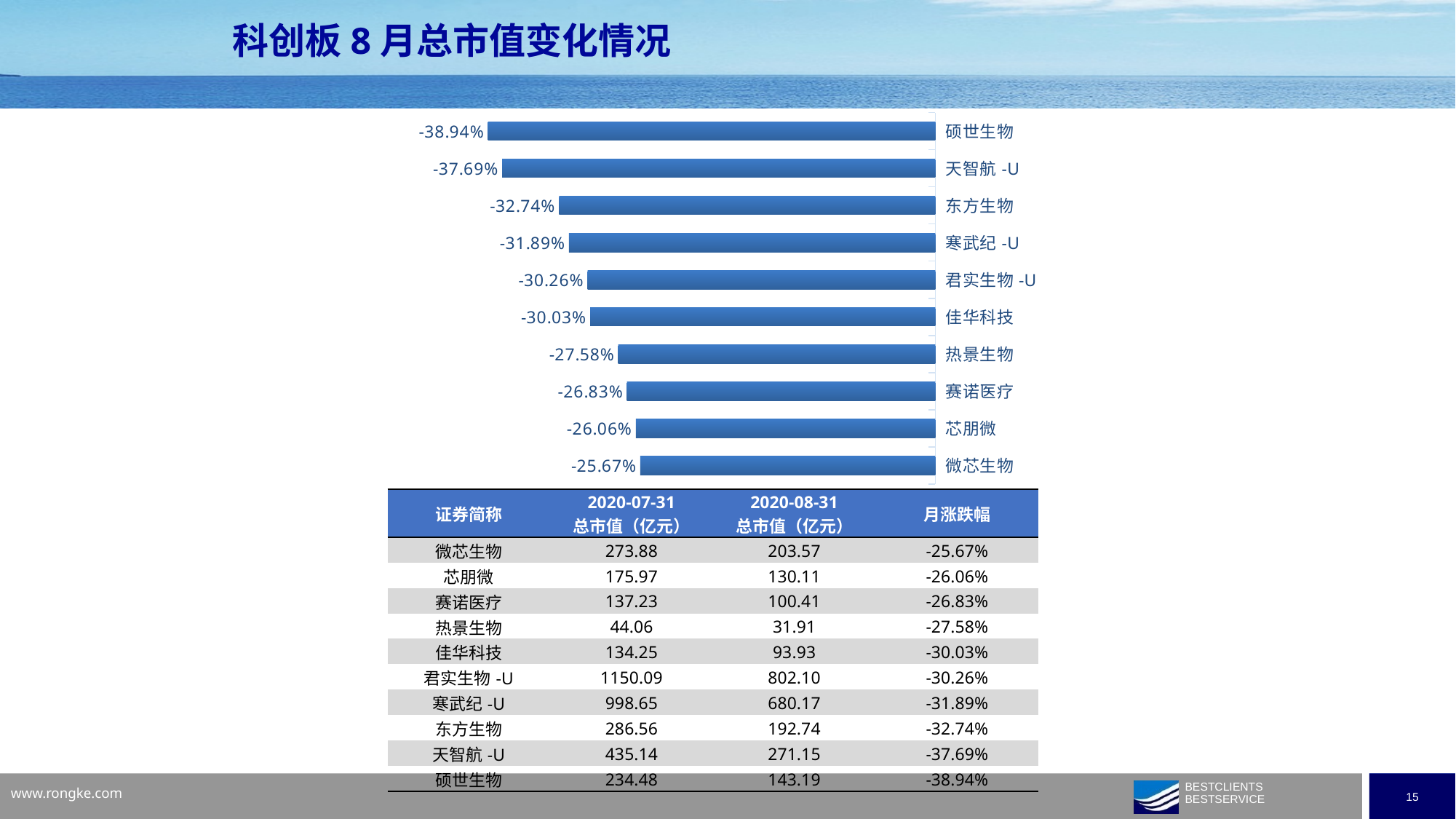
What is the value shown for 寒武纪 -U in the bar chart? -31.89% What is the value shown for 硕世生物 in the bar chart? -38.94% What is the title of the slide containing the chart? 科创板 8 月总市值变化情况 What is the difference in percentage points between the values for 天智航 -U and 东方生物 in the bar chart? 4.95 percentage points Which category in the bar chart has the largest decline (the most negative value)? 硕世生物 What kind of chart is shown on the slide? Bar chart What is the value shown for 热景生物 in the bar chart? -27.58% Which category in the bar chart has the smallest decline (the least negative value)? 微芯生物 How many categories are plotted in the bar chart? 10 What is the value shown for 芯朋微 in the bar chart? -26.06% Which has the larger decline in the bar chart, 君实生物 -U or 佳华科技? 君实生物 -U What is the difference in percentage points between the values for 硕世生物 and 微芯生物 in the bar chart? 13.27 percentage points